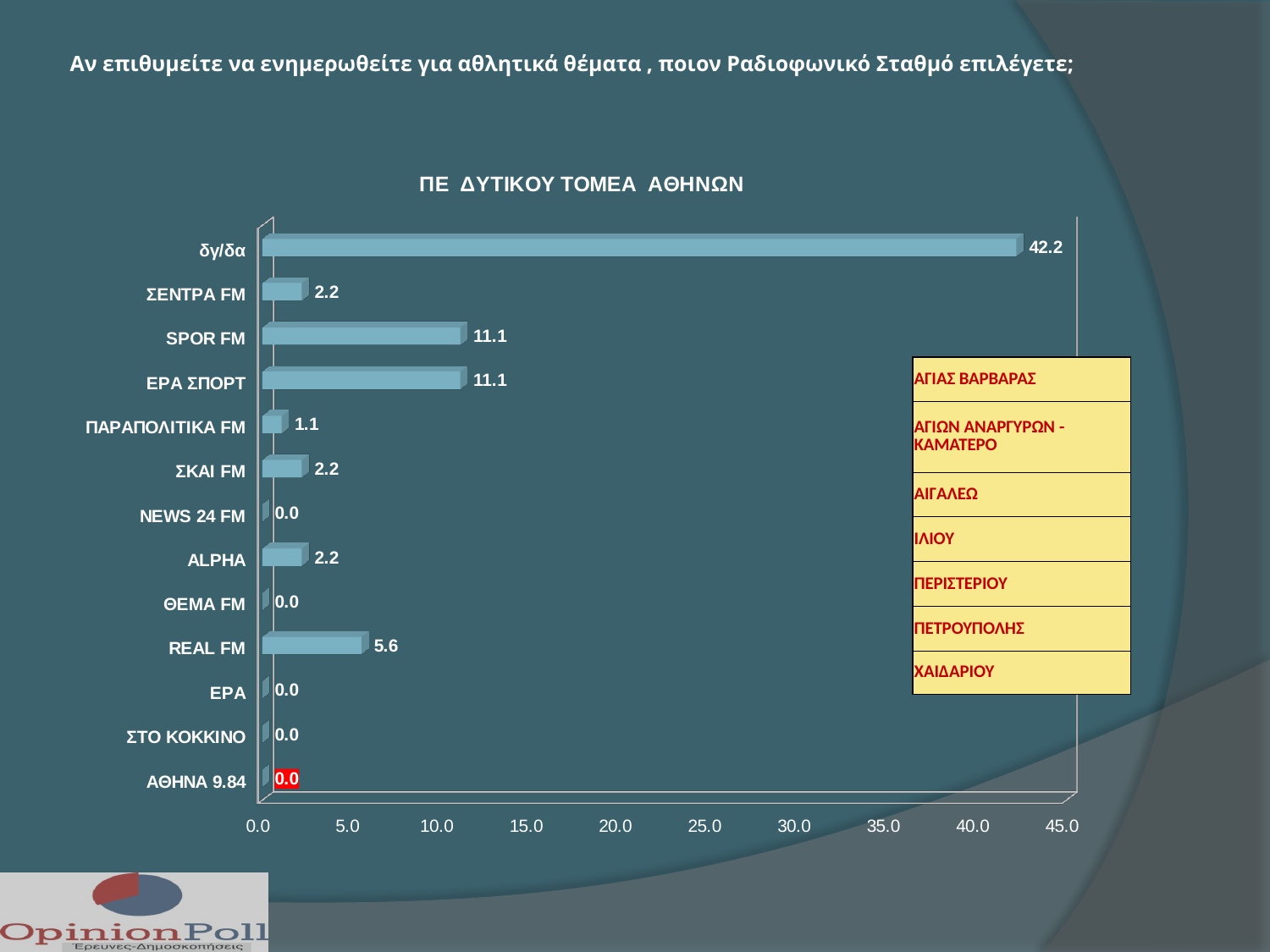
What is the difference between the values for δγ/δα and SPOR FM? 31.1 What is the difference between the values for REAL FM and ΣΚΑΙ FM? 3.4 What kind of chart is shown on the slide? bar chart What is the value for SPOR FM? 11.1 What is the value for δγ/δα? 42.2 How many categories are shown on the chart? 13 What is the value for REAL FM? 5.6 Which category has the highest value? δγ/δα What is the value for ΠΑΡΑΠΟΛΙΤΙΚΑ FM? 1.1 Is the value for δγ/δα greater or less than 40.0? greater Which is larger, the value for REAL FM or the value for ALPHA? REAL FM What is the title of the chart? ΠΕ ΔΥΤΙΚΟΥ ΤΟΜΕΑ ΑΘΗΝΩΝ